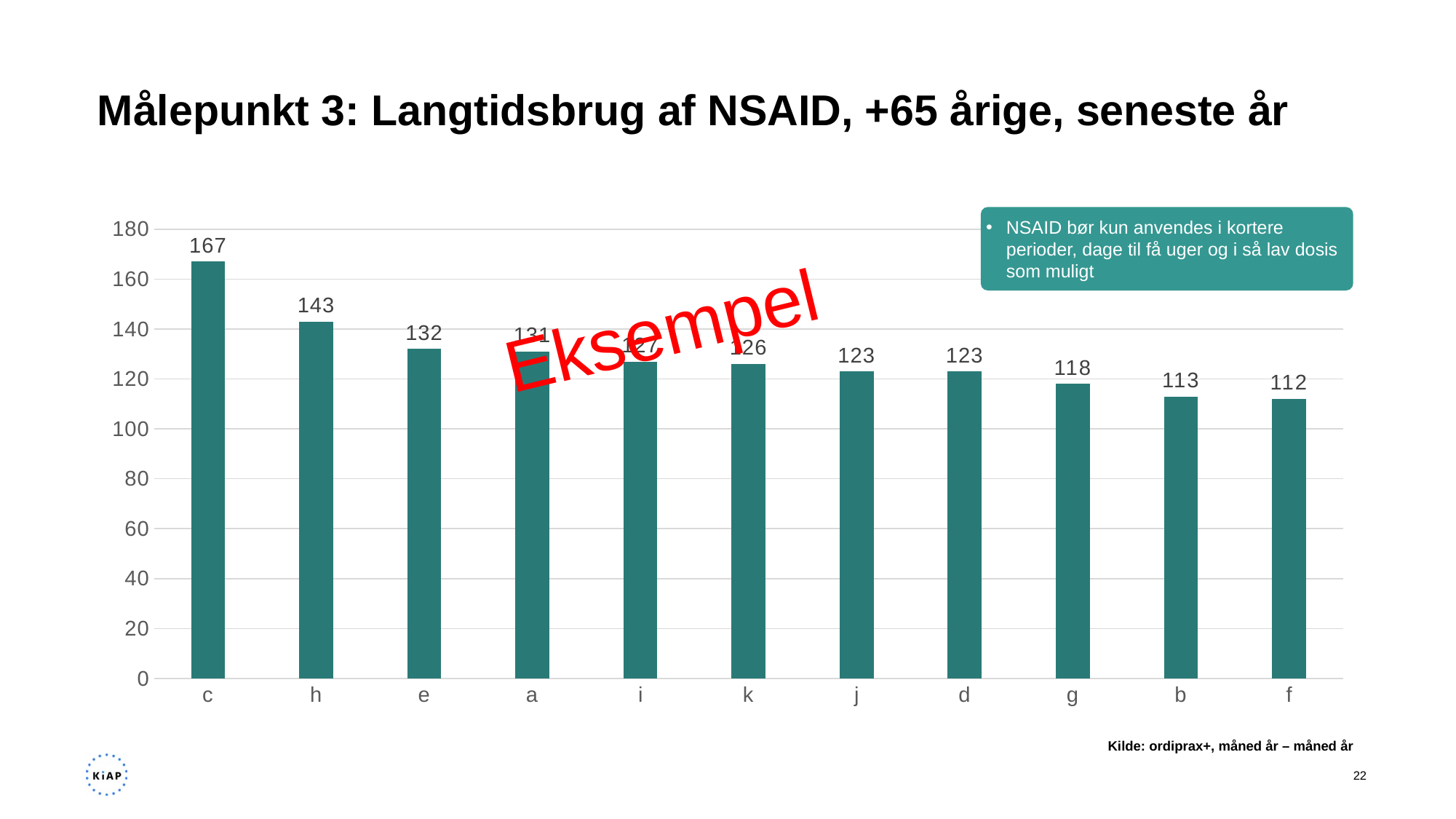
How many categories are shown on the x axis? 11 What is the value for category f? 112 Which category has the lowest value? f What is the value for category c? 167 What is the difference between the values for c and h? 24 Is the value for category i greater or less than 120? greater Which is larger, the value for e or the value for k? e What is the value for category g? 118 Which category has the highest value? c What kind of chart is shown on the slide? bar chart What is the value for category h? 143 Do the values rise or fall from left to right along the x axis? fall